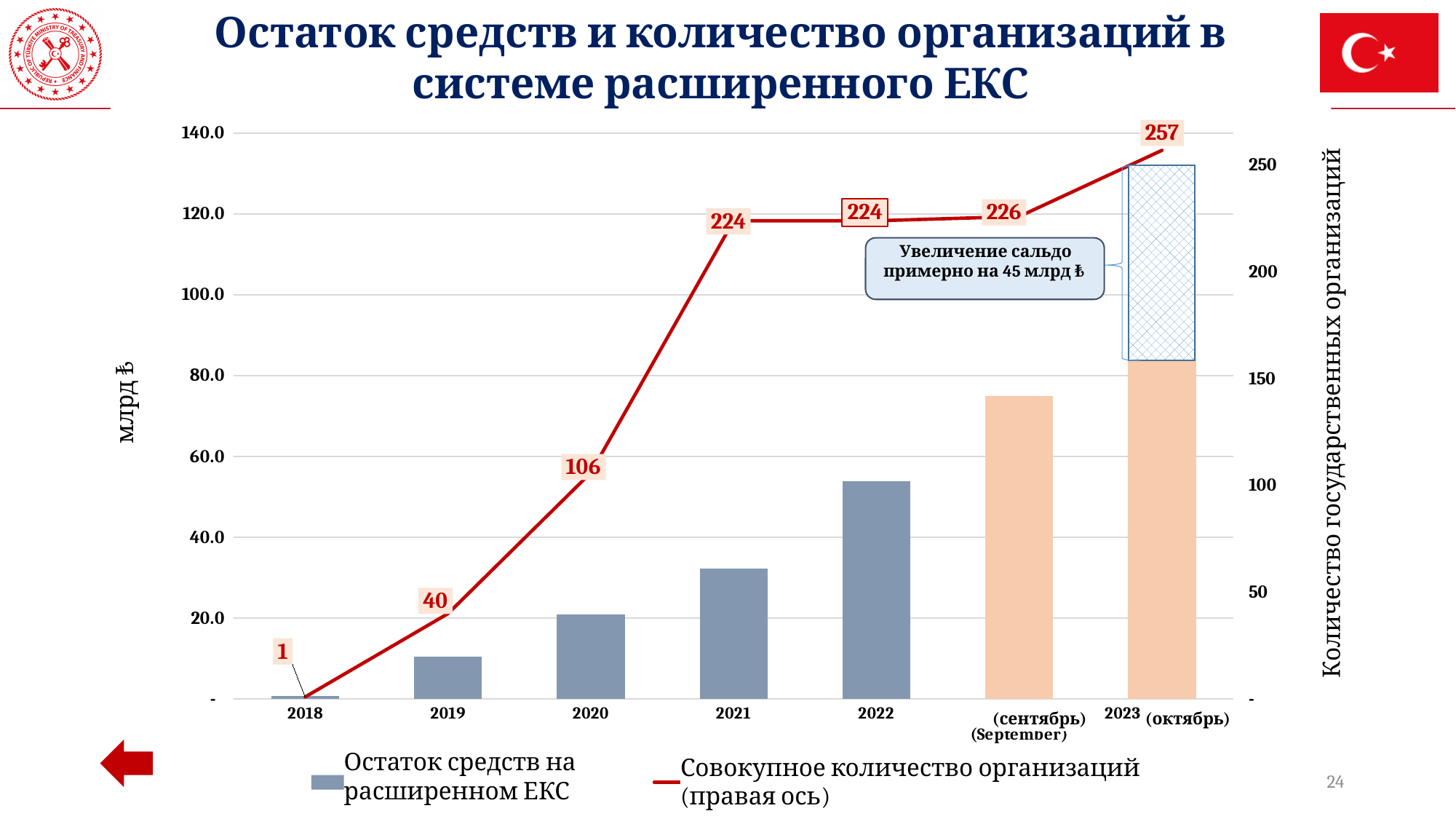
What is the cumulative number of organizations shown for 2023 (октябрь)? 257 Is the balance (Остаток средств) bar for 2022 greater or less than 40.0 billion ₺? greater What is the cumulative number of organizations shown for 2019? 40 By how much did the cumulative number of organizations increase from 2020 to 2021? 118 Which year has more organizations, 2019 or 2020? 2020 Is the balance (Остаток средств) bar for 2020 greater or less than 40.0 billion ₺? less How many categories are shown on the x axis? 7 Which category has the lowest cumulative number of organizations? 2018 How many series does the legend list? 2 Which category has the highest cumulative number of organizations? 2023 (октябрь) What is the cumulative number of organizations shown for 2020? 106 What is the difference in the number of organizations between 2023 (октябрь) and 2023 (сентябрь)? 31